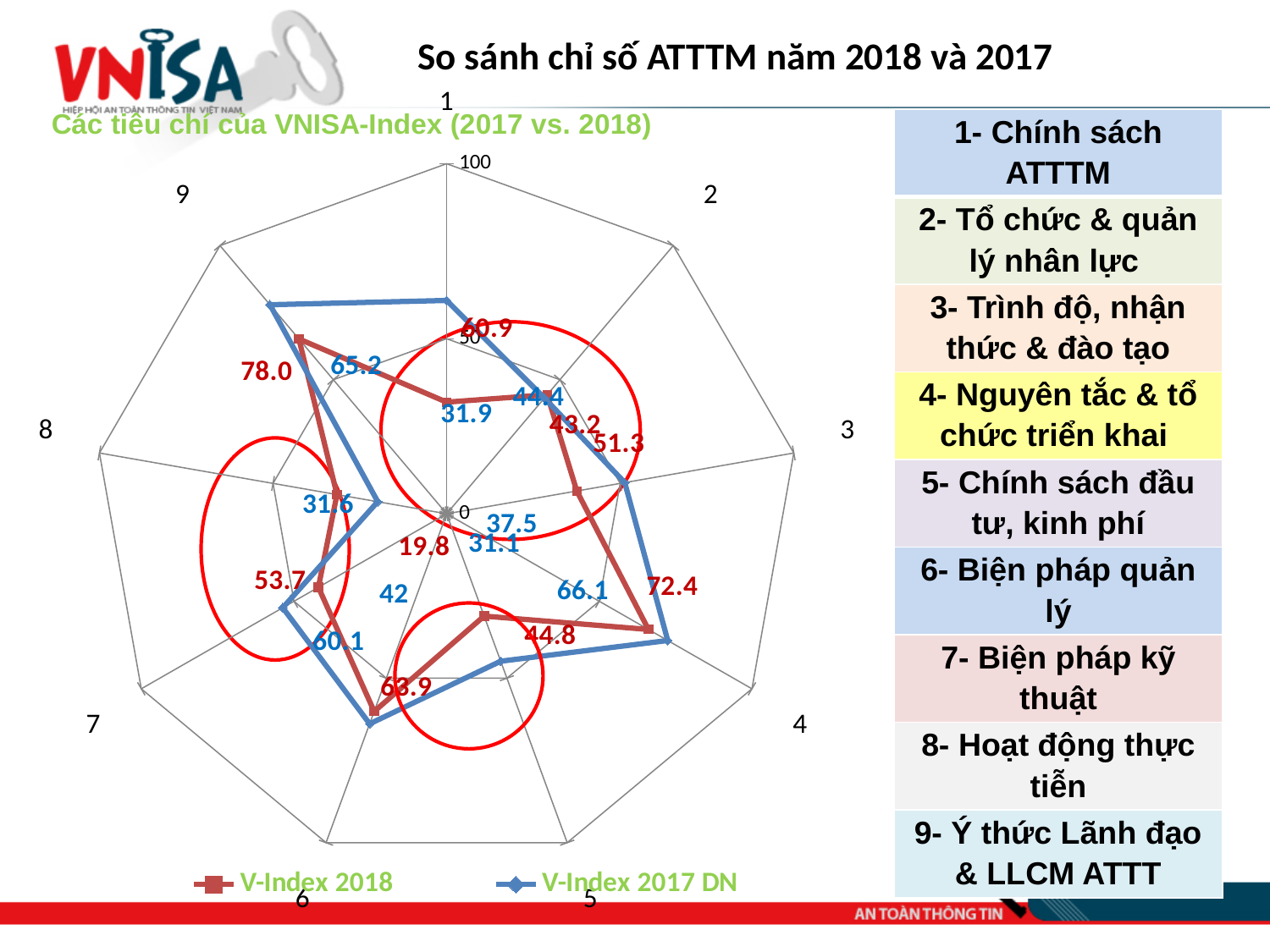
Which category has the lowest V-Index 2017 DN value? 8 What is the V-Index 2017 DN value for category 4? 72.4 Is the V-Index 2018 value for category 1 greater or less than 50? less What is the V-Index 2017 DN value for category 9? 78.0 What kind of chart is shown on the slide? Radar chart How many series does the chart legend list? 2 Which category has the highest V-Index 2017 DN value? 9 How many categories (axes) does the radar chart have? 9 What is the maximum value shown on the radar chart's scale? 100 What are the two series named in the legend? V-Index 2018 and V-Index 2017 DN What is the V-Index 2018 value for category 9? 65.2 What is the difference between the V-Index 2017 DN and V-Index 2018 values for category 9? 12.8